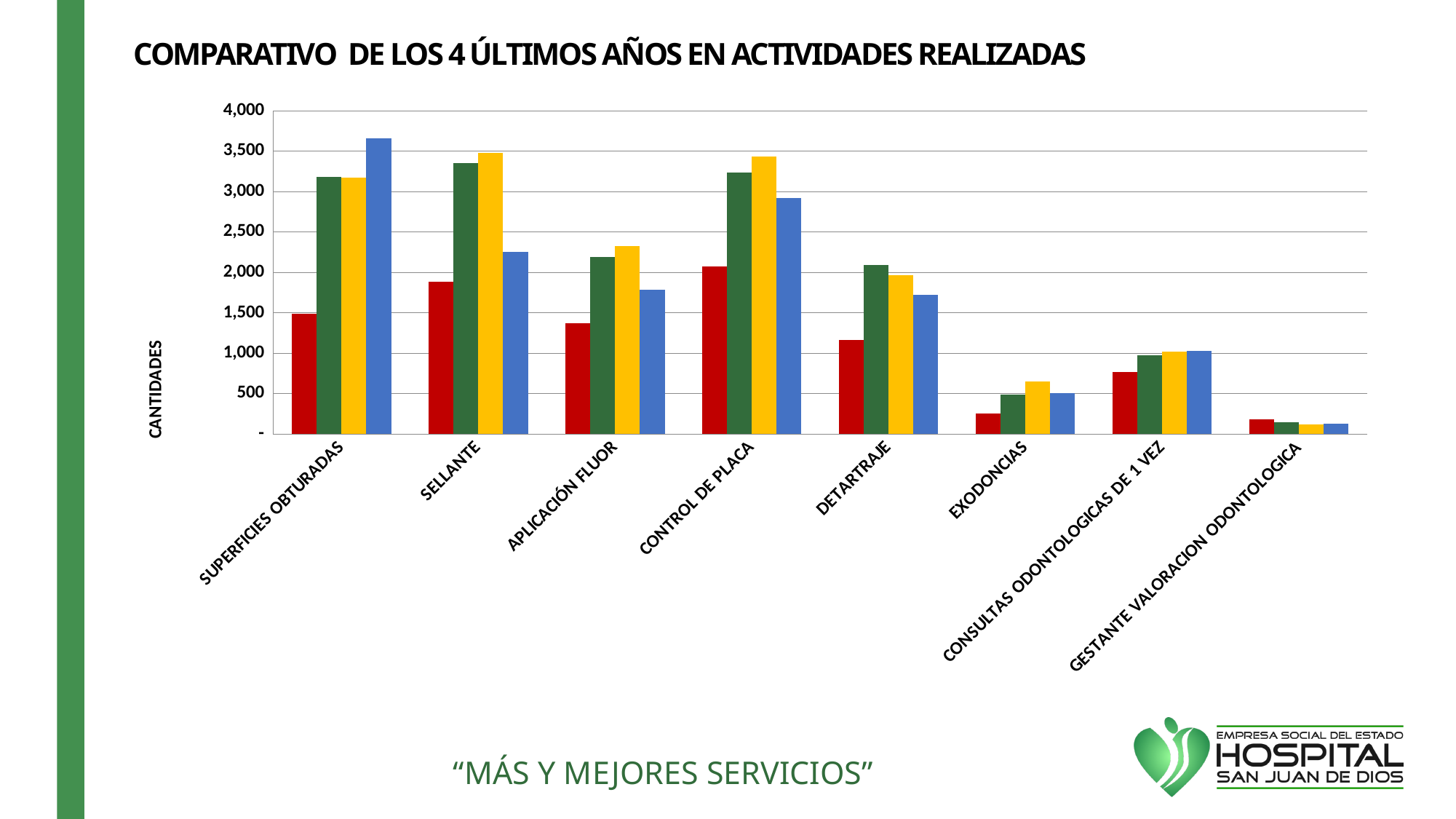
Which category has the lowest values overall in the chart? GESTANTE VALORACION ODONTOLOGICA Is the value of the red bar for EXODONCIAS greater or less than 500? less What is the label on the vertical axis of the chart? CANTIDADES How many categories are shown on the x axis of the chart? 8 Which has the larger yellow bar, CONTROL DE PLACA or DETARTRAJE? CONTROL DE PLACA What kind of chart is shown on the slide? bar chart Which category has the tallest bar in the chart? SUPERFICIES OBTURADAS What is the title of the chart? COMPARATIVO DE LOS 4 ÚLTIMOS AÑOS EN ACTIVIDADES REALIZADAS Which has the larger red bar, SELLANTE or APLICACIÓN FLUOR? SELLANTE Is the value of the blue bar for SUPERFICIES OBTURADAS greater or less than 3,500? greater How many bars are plotted for each category in the chart? 4 Is the value of the green bar for SELLANTE greater or less than 3,000? greater